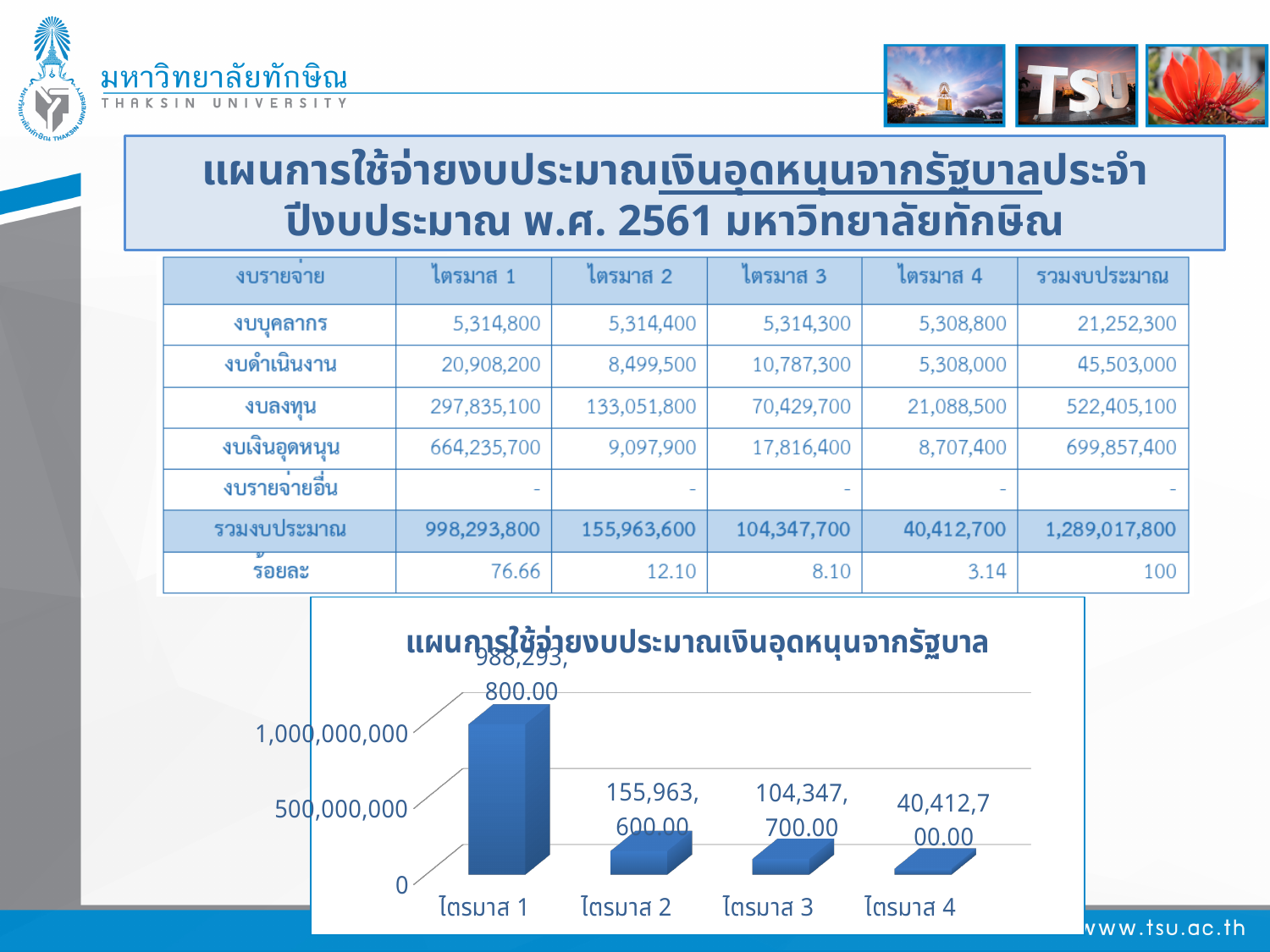
Do the values in the chart rise or fall from ไตรมาส 1 to ไตรมาส 4? fall What is the difference between the values for ไตรมาส 3 and ไตรมาส 4 in the chart? 63,935,000.00 Which quarter has the lowest value in the chart? ไตรมาส 4 What is the value shown for ไตรมาส 3 in the chart? 104,347,700.00 How many quarters (categories) are plotted in the chart? 4 What is the value shown for ไตรมาส 2 in the chart? 155,963,600.00 Is the value for ไตรมาส 1 in the chart greater or less than 500,000,000? greater Which quarter has the highest value in the chart? ไตรมาส 1 What is the title of the chart? แผนการใช้จ่ายงบประมาณเงินอุดหนุนจากรัฐบาล What kind of chart is shown on the slide? bar chart Which is larger in the chart, the value for ไตรมาส 2 or ไตรมาส 3? ไตรมาส 2 What is the value shown for ไตรมาส 4 in the chart? 40,412,700.00